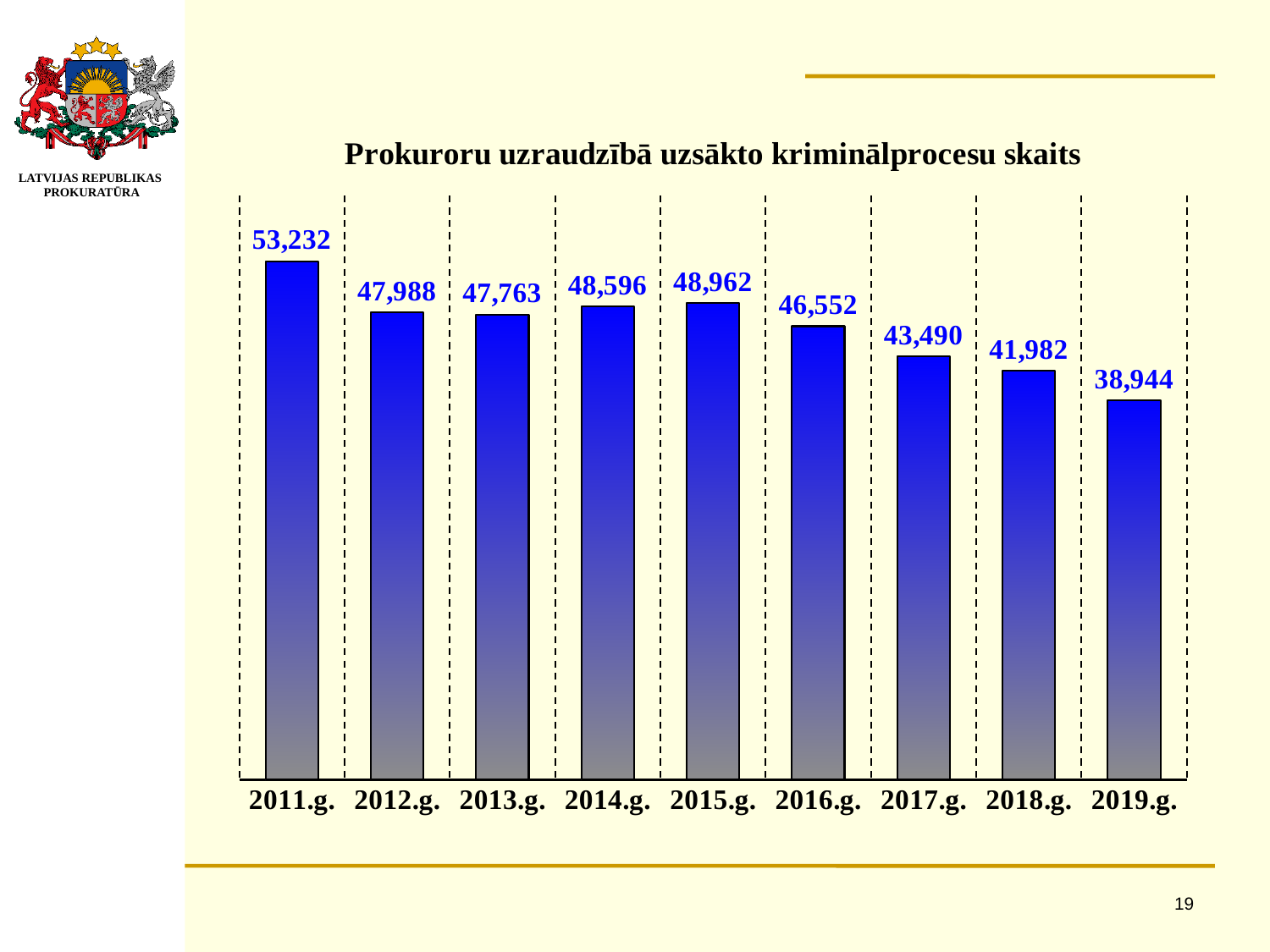
What is the difference between the values for 2011.g. and 2019.g.? 14,288 What is the value for 2019.g.? 38,944 What is the value for 2015.g.? 48,962 Which is larger, the value for 2014.g. or the value for 2015.g.? 2015.g. What is the difference between the values for 2017.g. and 2018.g.? 1,508 Which year has the lowest value? 2019.g. What kind of chart is this? bar chart How many years are shown on the chart? 9 Which is larger, the value for 2012.g. or the value for 2013.g.? 2012.g. What is the value for 2011.g.? 53,232 Which year has the highest value? 2011.g. What is the title of the chart? Prokuroru uzraudzībā uzsākto kriminālprocesu skaits